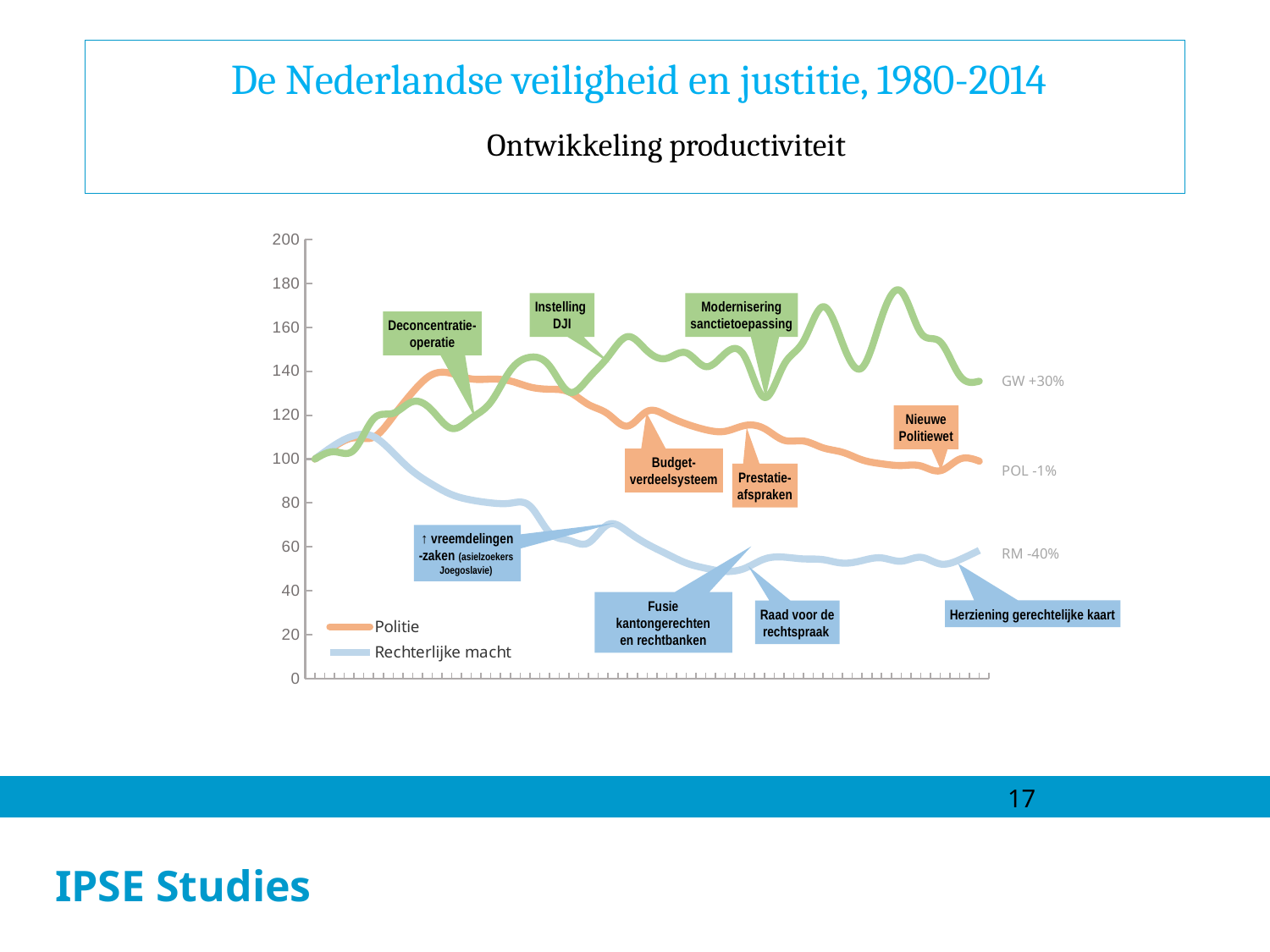
What kind of chart is shown on the slide? line chart Which series ends at the highest level at the right of the chart? GW Does the Rechterlijke macht line rise or fall overall from left to right? fall Is the highest point of the green GW line greater or less than 160? greater What percentage change is labelled at the end of the GW line? +30% Is the final value of the Rechterlijke macht line greater or less than 80? less What percentage change is labelled at the end of the RM line? -40% How many series does the chart legend list? 2 What is the subtitle of the chart on the slide? Ontwikkeling productiviteit Which series ends at the lowest level at the right of the chart? RM What percentage change is labelled at the end of the POL line? -1% At the right end of the chart, which is higher: the GW line or the Politie line? GW